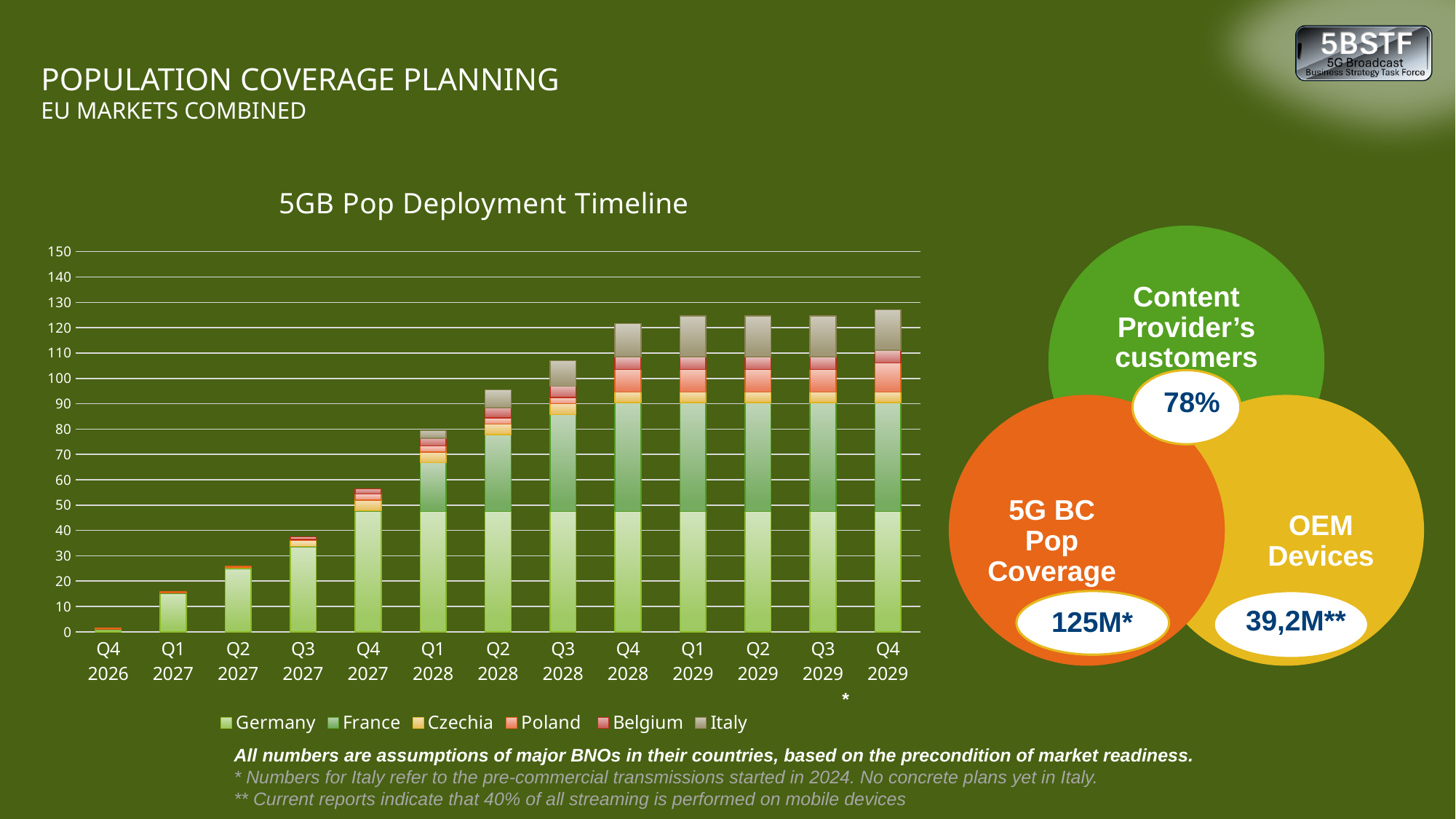
Which country is listed first in the legend of the 5GB Pop Deployment Timeline chart? Germany Is the total bar for Q4 2027 in the 5GB Pop Deployment Timeline chart greater or less than 50? greater Do the total bar heights in the 5GB Pop Deployment Timeline chart rise or fall from Q4 2026 to Q4 2029? rise Is the total bar for Q2 2027 in the 5GB Pop Deployment Timeline chart greater or less than 20? greater Is the total bar for Q3 2027 in the 5GB Pop Deployment Timeline chart greater or less than 40? less How many countries does the legend of the 5GB Pop Deployment Timeline chart list? 6 How many quarters are shown on the x axis of the 5GB Pop Deployment Timeline chart? 13 Which quarter has the lowest total bar in the 5GB Pop Deployment Timeline chart? Q4 2026 What kind of chart is the 5GB Pop Deployment Timeline? stacked bar chart Which is larger in the 5GB Pop Deployment Timeline chart, the total bar for Q1 2028 or the total bar for Q4 2027? Q1 2028